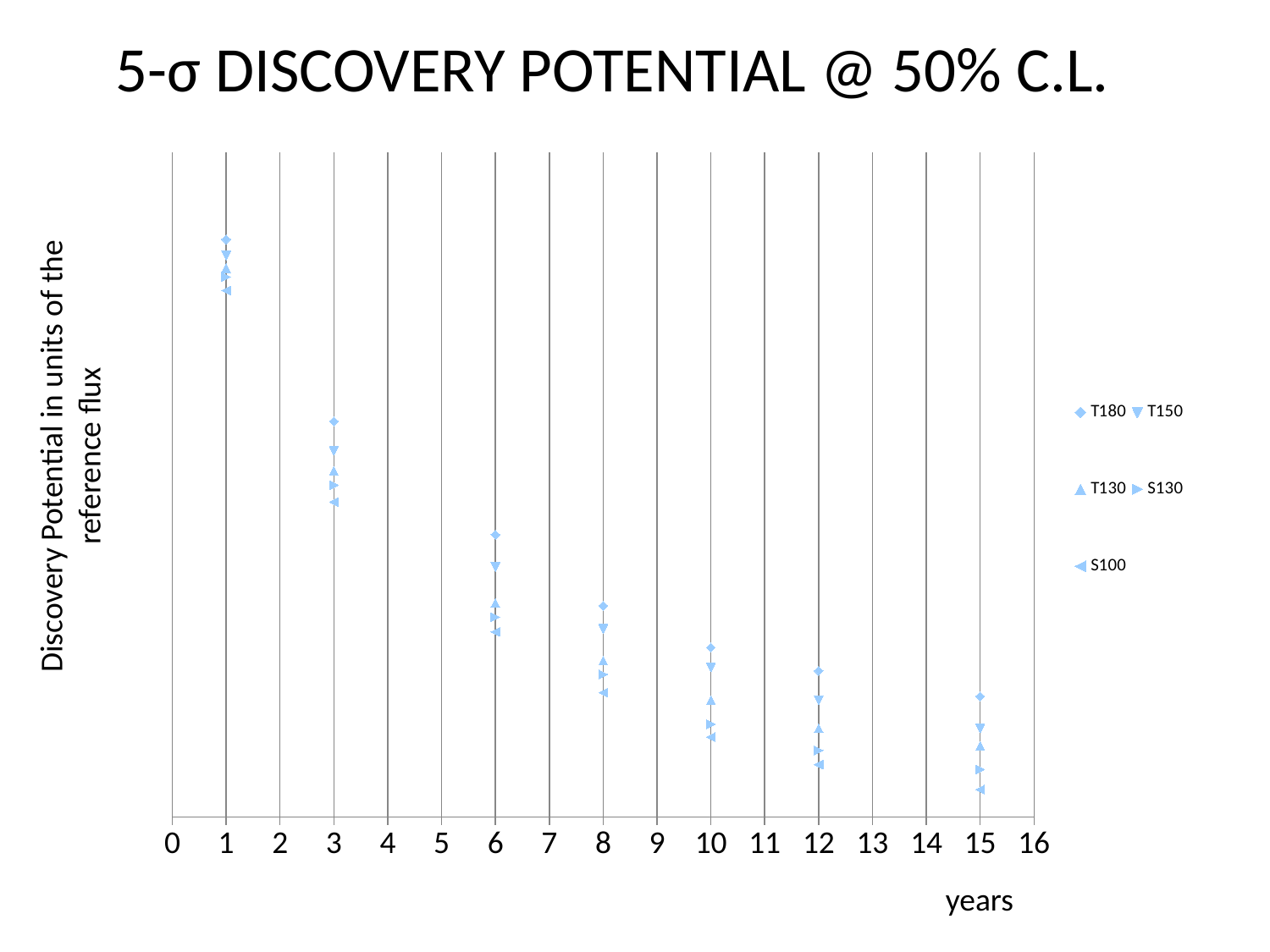
At 3 years, which series has the highest value? T180 At which year does the S100 series reach its lowest value? 15 How many series does the legend list? 5 At which year does the T180 series reach its highest value? 1 What is the title of the chart? 5-σ DISCOVERY POTENTIAL @ 50% C.L. How many data points are plotted for the T180 series? 7 What is the label of the x axis? years Do the values of the T180 series rise or fall as the number of years increases? Fall At 15 years, which series has the higher value, T180 or S100? T180 What kind of chart is shown on the slide? Scatter chart At 6 years, which series has the higher value, T150 or S100? T150 At 10 years, which series has the lowest value? S100